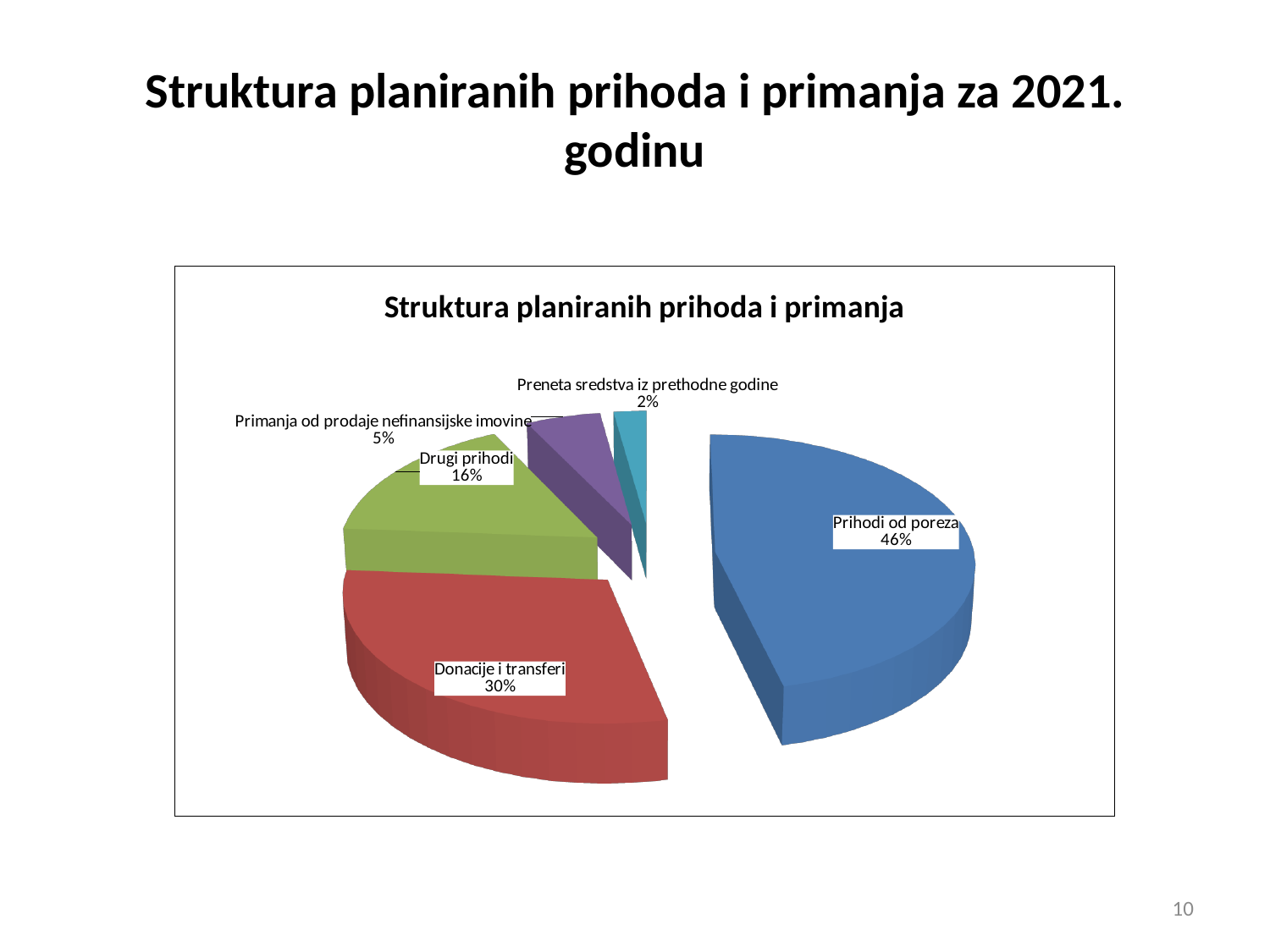
What is the difference in percentage points between Prihodi od poreza and Donacije i transferi? 16 How many slices does the pie chart have? 5 What is the value shown for Preneta sredstva iz prethodne godine? 2% What share of the pie does Prihodi od poreza represent? 46% Which category has the largest share of the pie? Prihodi od poreza What is the title of the chart? Struktura planiranih prihoda i primanja What is the value shown for Primanja od prodaje nefinansijske imovine? 5% Which is larger, Drugi prihodi or Primanja od prodaje nefinansijske imovine? Drugi prihodi What is the value shown for Drugi prihodi? 16% What share of the pie does Donacije i transferi represent? 30% What type of chart is shown on the slide? Pie chart Which category has the smallest share of the pie? Preneta sredstva iz prethodne godine